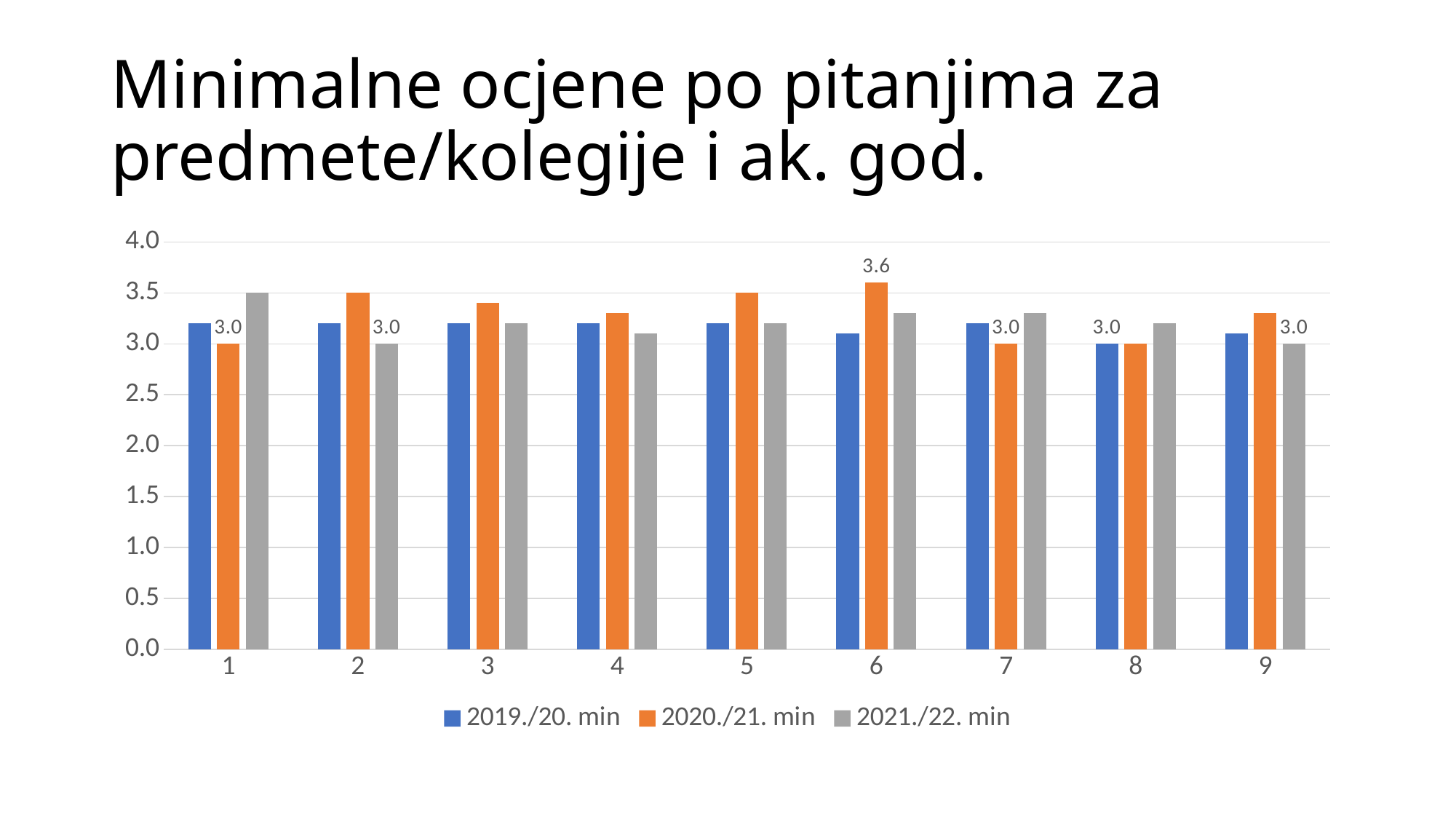
Which category has the highest 2020./21. min value? 6 How many categories are shown on the x axis? 9 What kind of chart is shown on the slide? bar chart What is the 2020./21. min value for category 1? 3.0 How many series does the legend list? 3 Which is larger: the 2020./21. min value for category 6 or for category 1? category 6 What is the 2020./21. min value for category 6? 3.6 Is the 2021./22. min value for category 6 greater or less than 3.0? greater What is the title of the chart on the slide? Minimalne ocjene po pitanjima za predmete/kolegije i ak. god. What is the difference between the 2020./21. min values for category 6 and category 7? 0.6 What is the 2021./22. min value for category 9? 3.0 What is the 2019./20. min value for category 8? 3.0